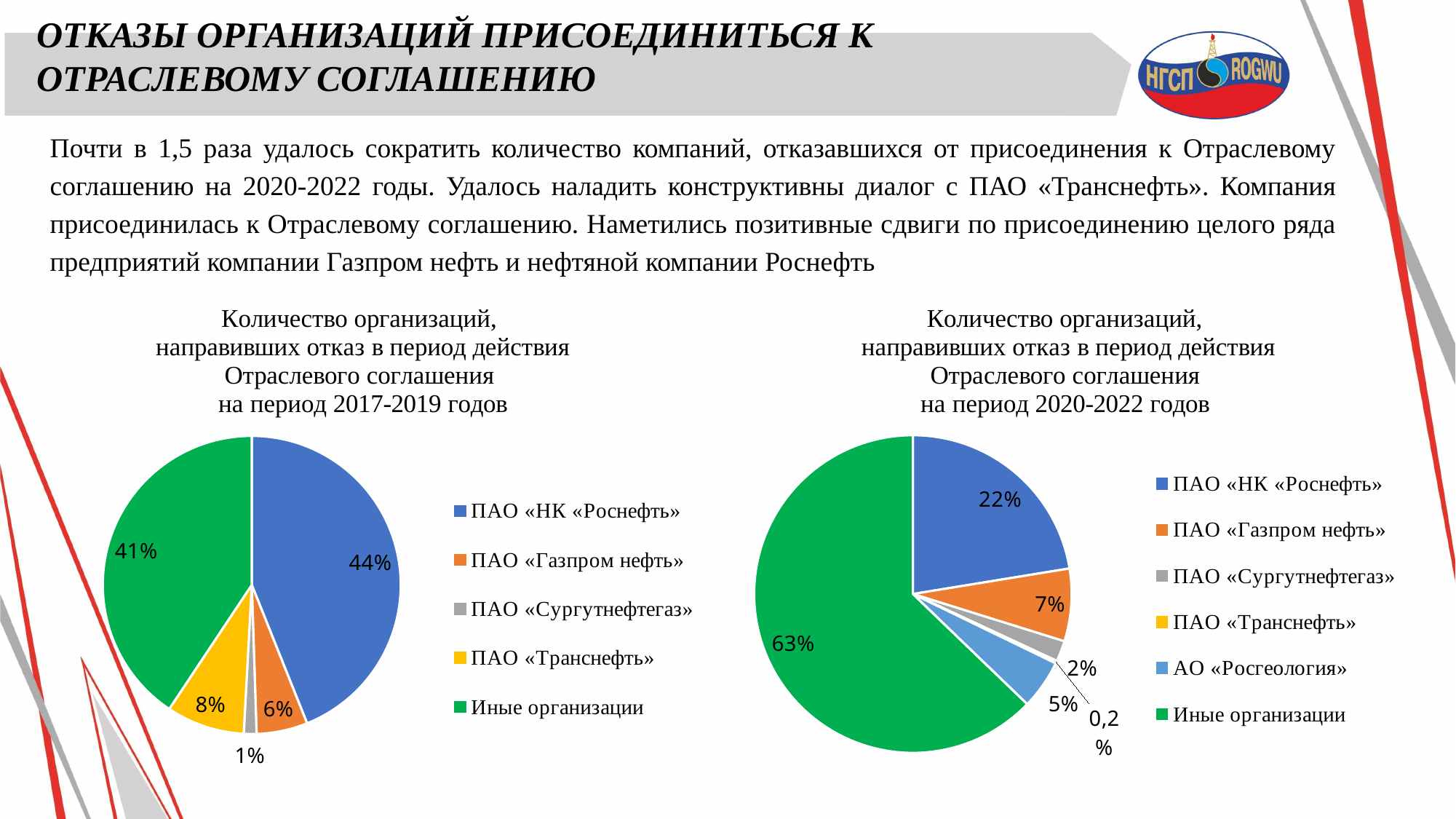
On the right pie chart (2020-2022), which is larger: the share of ПАО «Газпром нефть» or the share of АО «Росгеология»? ПАО «Газпром нефть» On the left pie chart (2017-2019), what is the difference between the shares of ПАО «НК «Роснефть» and Иные организации? 3% On the left pie chart (2017-2019), what share is labelled for ПАО «Транснефть»? 8% On the right pie chart (2020-2022), which category has the largest share? Иные организации On the left pie chart (2017-2019), which category has the smallest share? ПАО «Сургутнефтегаз» What type of chart is used on the left side of the slide? Pie chart How many categories does the legend of the right pie chart (2020-2022) list? 6 On the right pie chart (2020-2022), what share is labelled for АО «Росгеология»? 5% On the left pie chart (2017-2019), what share is labelled for Иные организации? 41% On the right pie chart (2020-2022), what share is labelled for ПАО «Транснефть»? 0,2% On the left pie chart (2017-2019), what share is labelled for ПАО «НК «Роснефть»? 44% On the right pie chart (2020-2022), what share is labelled for ПАО «НК «Роснефть»? 22%